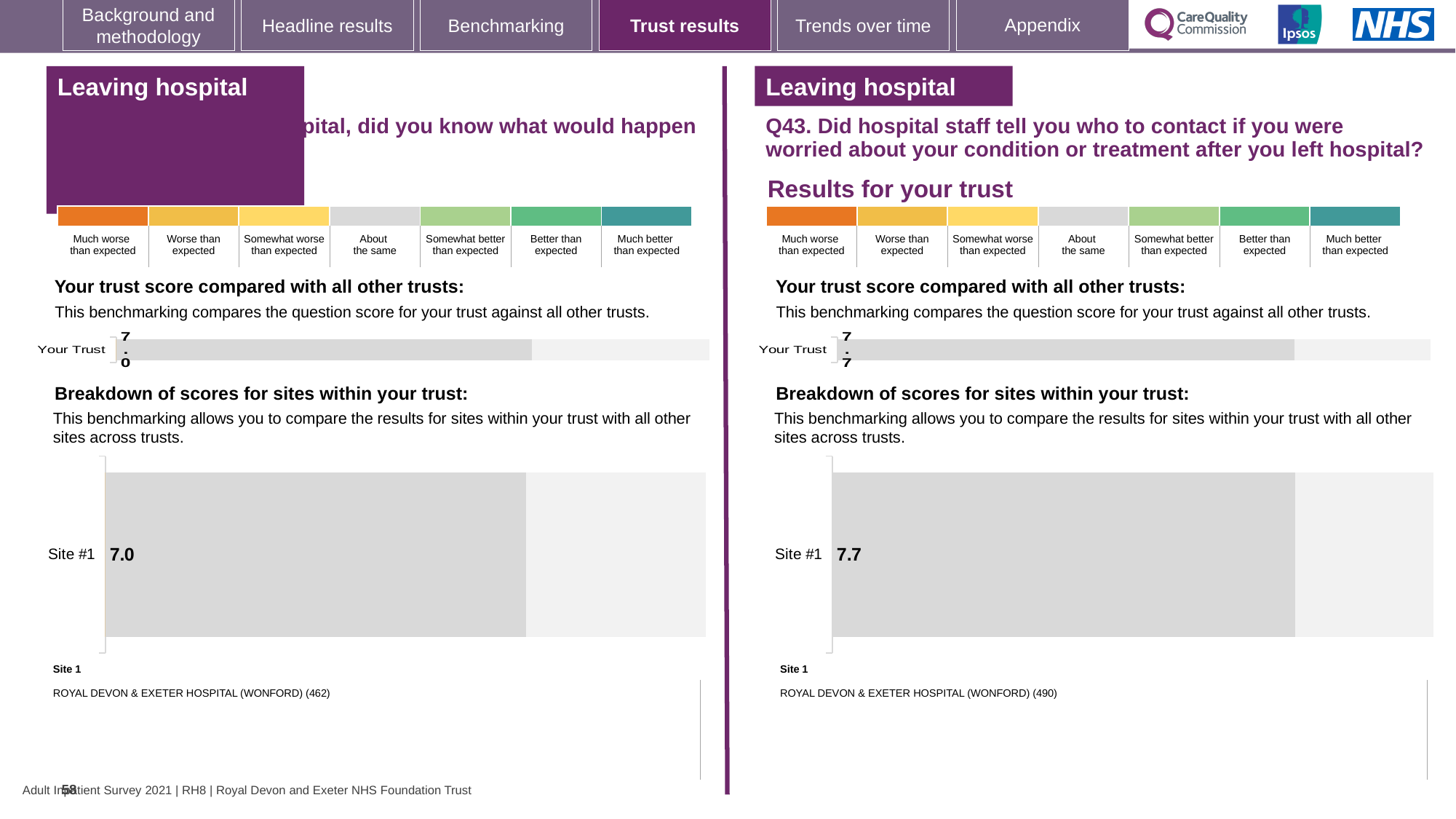
Which Site #1 score is larger: the one on the left half of the slide or the one on the right half (Q43)? Right half (Q43) On the left half of the slide, what is the score shown for Site #1 in the breakdown of scores for sites within your trust? 7.0 On the right half of the slide (Q43), what is the score shown for Site #1 in the breakdown of scores for sites within your trust? 7.7 On the right half of the slide (Q43), which hospital is listed as Site 1 below the breakdown chart? ROYAL DEVON & EXETER HOSPITAL (WONFORD) (490) What type of chart is used to show the Site #1 score on the right half of the slide (Q43)? Bar chart How many sites are shown in the breakdown of scores chart on the right half of the slide (Q43)? 1 On the right half of the slide (Q43), what is the 'Your Trust' score in the chart comparing your trust score with all other trusts? 7.7 On the left half of the slide, what number appears in brackets after ROYAL DEVON & EXETER HOSPITAL (WONFORD) in the Site 1 listing? 462 What is the difference between the Site #1 score on the right half of the slide (Q43) and the Site #1 score on the left half? 0.7 On the left half of the slide, what is the 'Your Trust' score in the chart comparing your trust score with all other trusts? 7.0 How many sites are shown in the breakdown of scores chart on the left half of the slide? 1